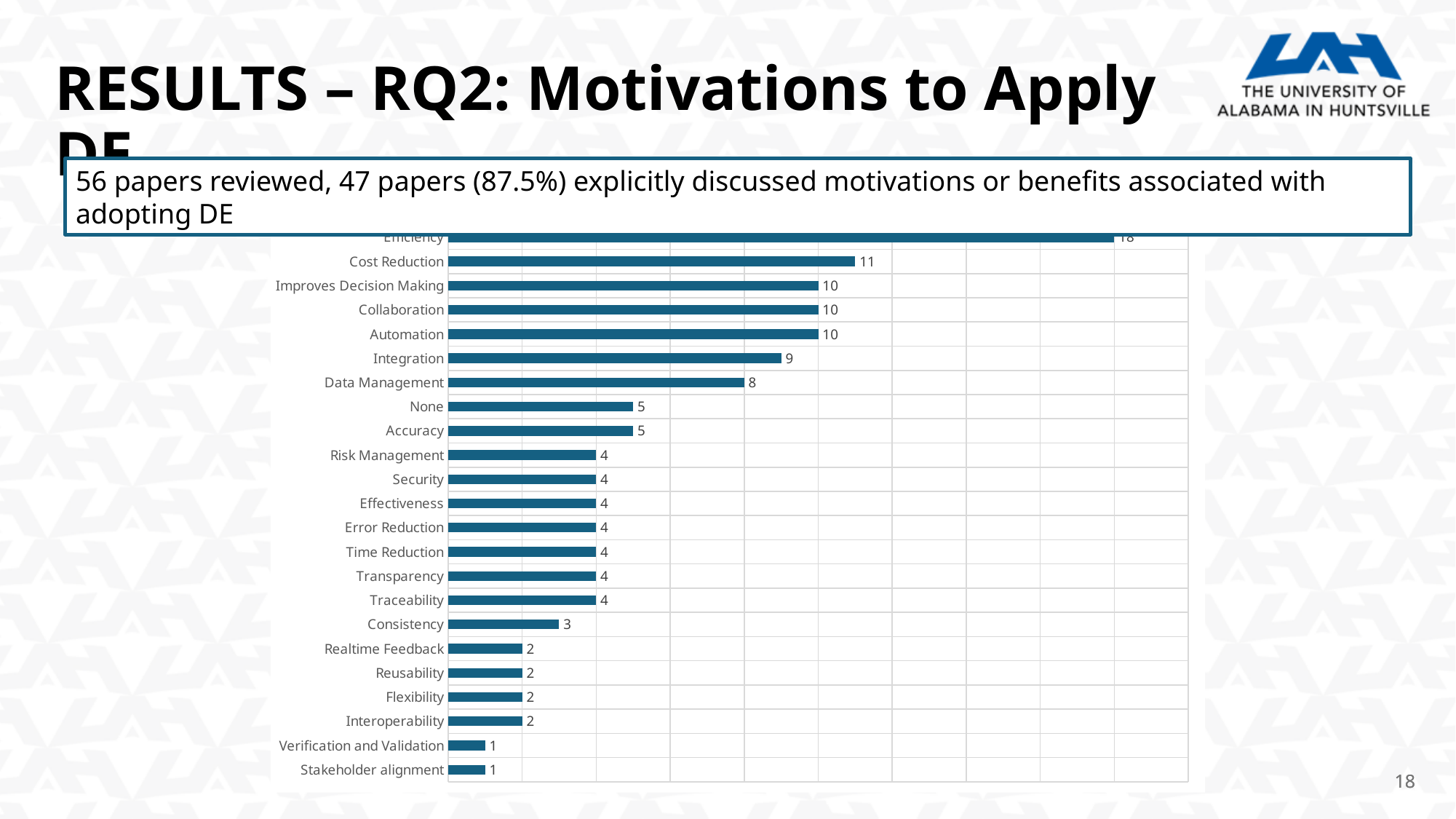
Do the bar values increase or decrease going from the top of the chart to the bottom? Decrease What kind of chart is shown on the slide? Bar chart What is the value for Consistency? 3 What is the value for Integration? 9 What is the value for Cost Reduction? 11 What is the difference between the values for Integration and Consistency? 6 What is the value for Accuracy? 5 What is the value for Interoperability? 2 What is the value for Data Management? 8 What is the difference between the values for Cost Reduction and Data Management? 3 Which has a larger value, Cost Reduction or Automation? Cost Reduction What is the value for Stakeholder alignment? 1